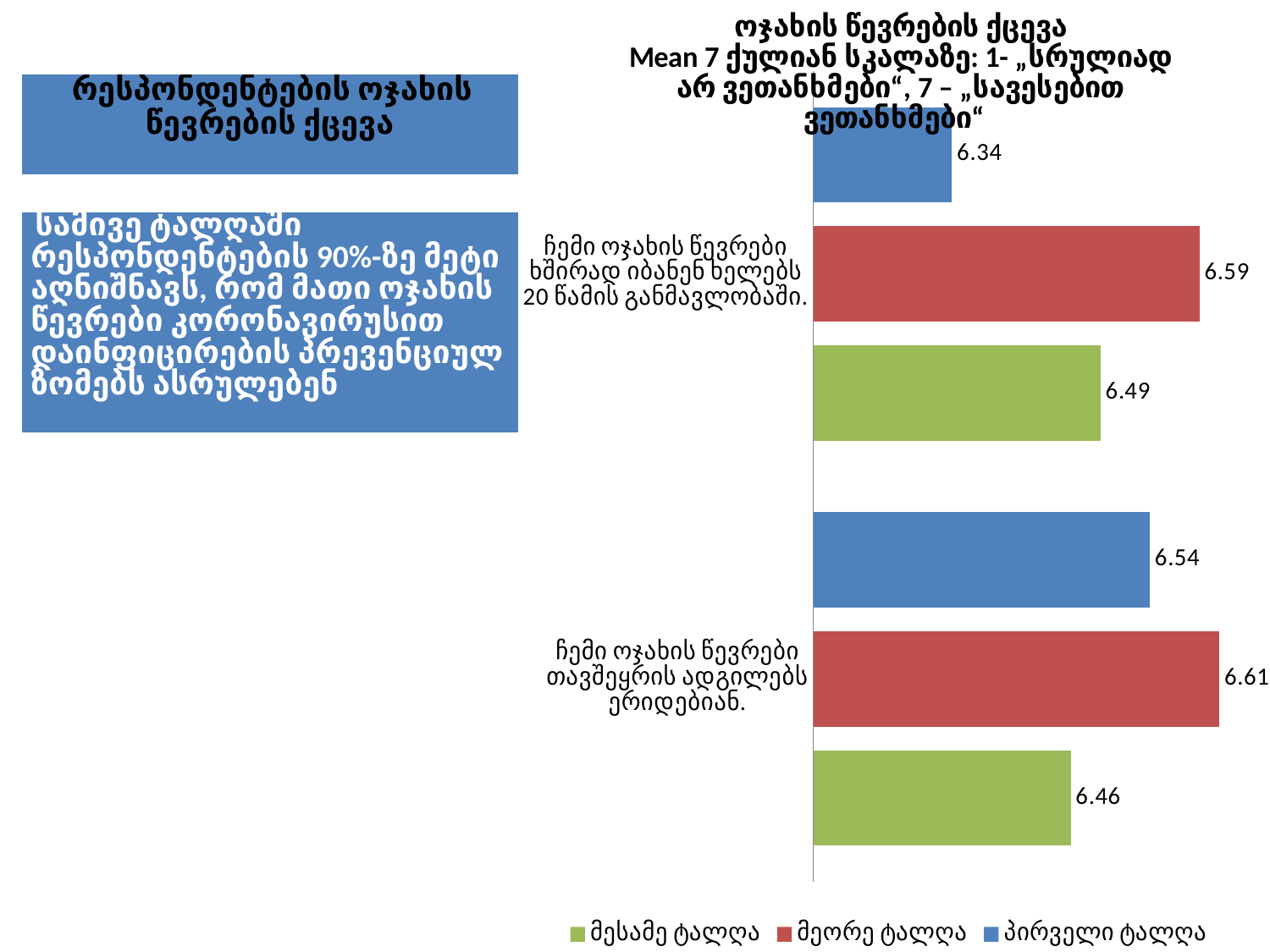
Which is larger: the პირველი ტალღა value for "ჩემი ოჯახის წევრები თავშეყრის ადგილებს ერიდებიან." or the პირველი ტალღა value for "ჩემი ოჯახის წევრები ხშირად იბანენ ხელებს 20 წამის განმავლობაში."? ჩემი ოჯახის წევრები თავშეყრის ადგილებს ერიდებიან. What is the value for პირველი ტალღა in the category "ჩემი ოჯახის წევრები ხშირად იბანენ ხელებს 20 წამის განმავლობაში."? 6.34 What type of chart is shown on the slide? bar chart What colour are the bars for მეორე ტალღა? red How many series does the legend list? 3 Which series has the lowest value in the category "ჩემი ოჯახის წევრები თავშეყრის ადგილებს ერიდებიან."? მესამე ტალღა What is the value for პირველი ტალღა in the category "ჩემი ოჯახის წევრები თავშეყრის ადგილებს ერიდებიან."? 6.54 Which series has the highest value in the category "ჩემი ოჯახის წევრები ხშირად იბანენ ხელებს 20 წამის განმავლობაში."? მეორე ტალღა How many categories are plotted on the chart? 2 What is the value for მესამე ტალღა in the category "ჩემი ოჯახის წევრები ხშირად იბანენ ხელებს 20 წამის განმავლობაში."? 6.49 What is the value for მეორე ტალღა in the category "ჩემი ოჯახის წევრები თავშეყრის ადგილებს ერიდებიან."? 6.61 What is the difference between the მეორე ტალღა and პირველი ტალღა values in the category "ჩემი ოჯახის წევრები ხშირად იბანენ ხელებს 20 წამის განმავლობაში."? 0.25